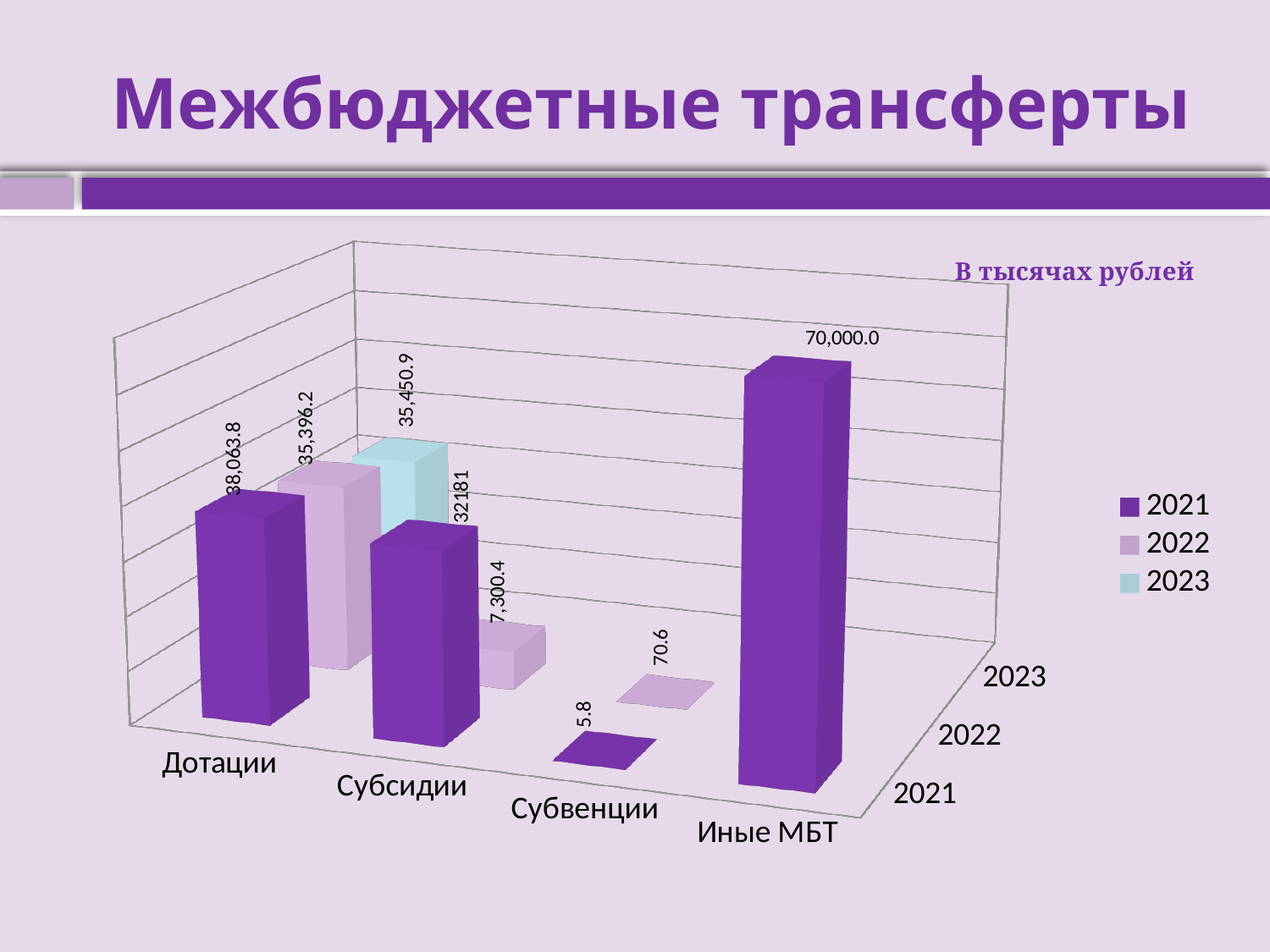
What is the value for Иные МБТ in the 2021 series? 70,000.0 How many series does the legend list? 3 What is the difference between the 2021 and 2022 values for Дотации? 2,667.6 What is the value for Дотации in the 2023 series? 35,450.9 What is the value for Дотации in the 2021 series? 38,063.8 What is the value for Субсидии in the 2022 series? 7,300.4 Which category has the highest value in the 2021 series? Иные МБТ What kind of chart is shown on the slide? Bar chart Which is larger for Субвенции: the 2021 value or the 2022 value? 2022 What is the value for Субвенции in the 2021 series? 5.8 Which category has the lowest value in the 2021 series? Субвенции What unit is stated for the chart values? В тысячах рублей